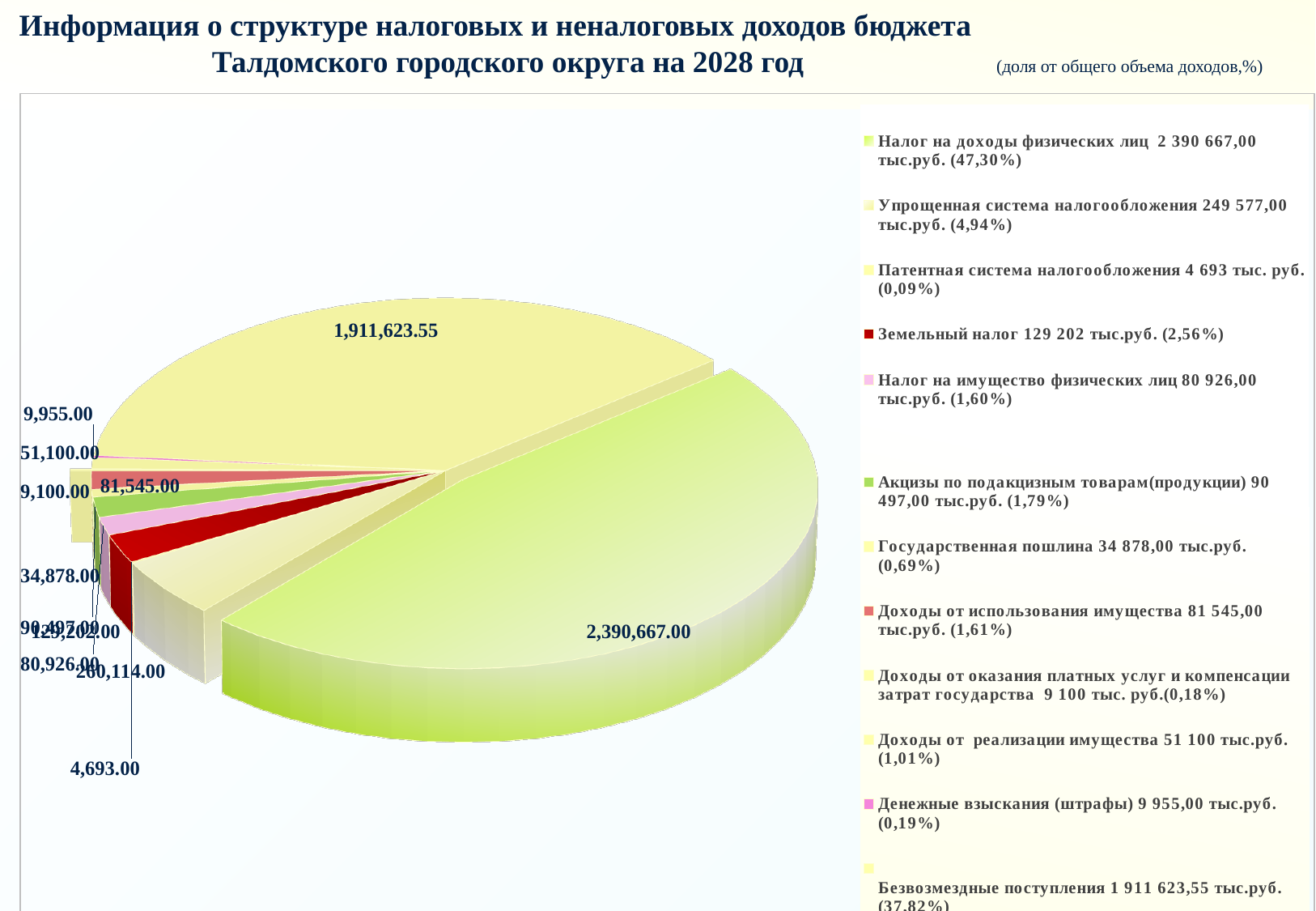
Which category has the smallest slice of the pie? Патентная система налогообложения What share of total revenue does Безвозмездные поступления represent, according to the legend? 37,82% What is the data label value for the largest slice (Налог на доходы физических лиц)? 2,390,667.00 Which category has the largest slice of the pie? Налог на доходы физических лиц What share of total revenue does Налог на доходы физических лиц represent, according to the legend? 47,30% What kind of chart is shown on the slide? pie chart Which is larger: the value for Доходы от реализации имущества or the value for Государственная пошлина? Доходы от реализации имущества How many categories does the legend list? 12 What is the difference between the data labels for Налог на доходы физических лиц (2,390,667.00) and Безвозмездные поступления (1,911,623.55)? 479,043.45 What is the data label value for Безвозмездные поступления? 1,911,623.55 What is the data label value for Патентная система налогообложения? 4,693.00 What is the data label value for Доходы от использования имущества? 81,545.00